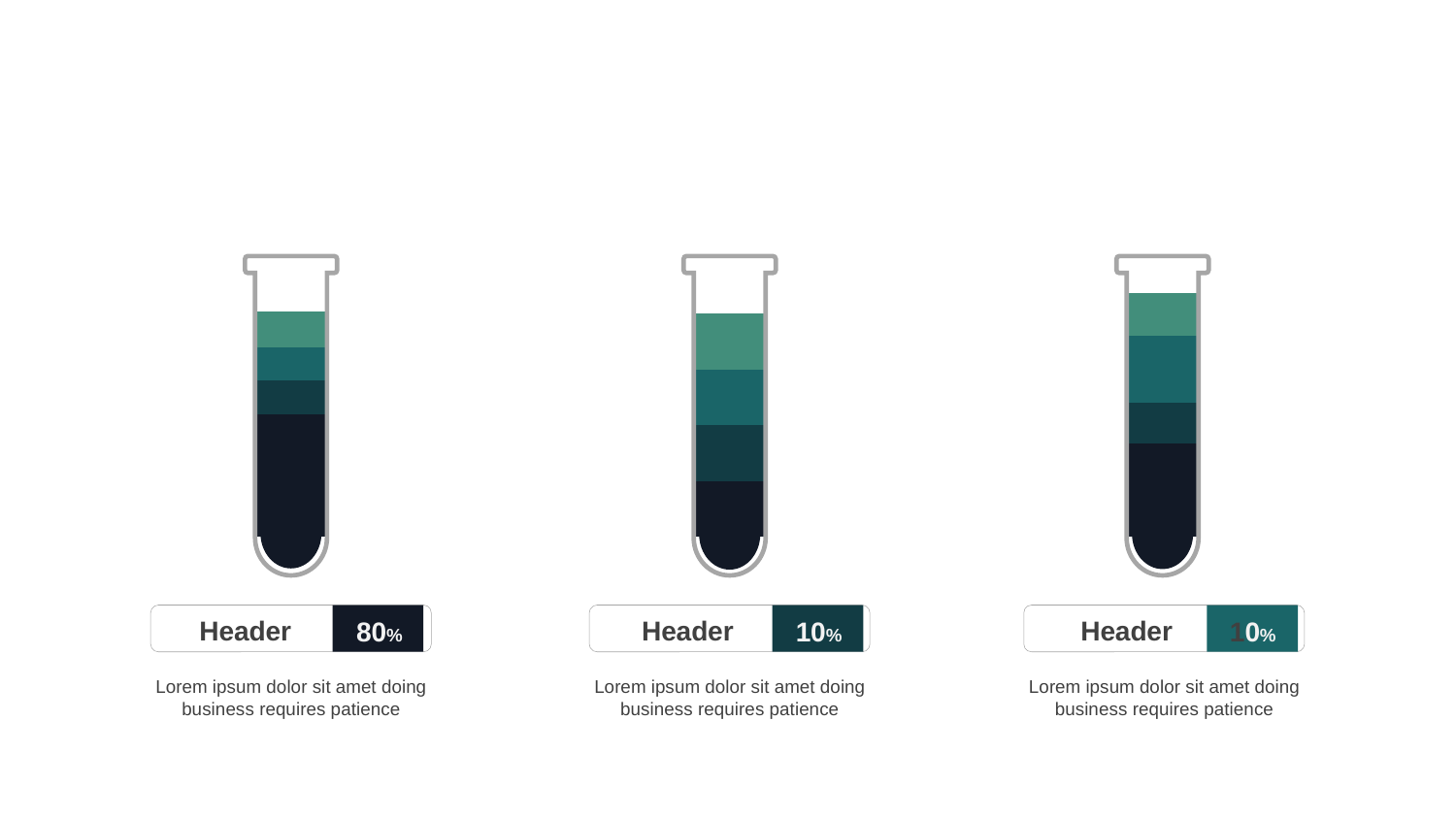
How many coloured segments are in each test tube? 4 Which test tube shows the highest percentage? The left one Which shows a larger percentage, the left test tube or the middle test tube? The left test tube What is the difference between the percentage of the left test tube and the middle test tube? 70% Is the percentage for the left test tube greater or less than 50%? greater Is the percentage for the middle test tube greater or less than 50%? less What percentage is shown for the middle test tube? 10% What label text appears next to each percentage? Header How many test tubes are shown on the slide? 3 What percentage is shown for the right test tube? 10% What percentage is shown for the left test tube? 80%